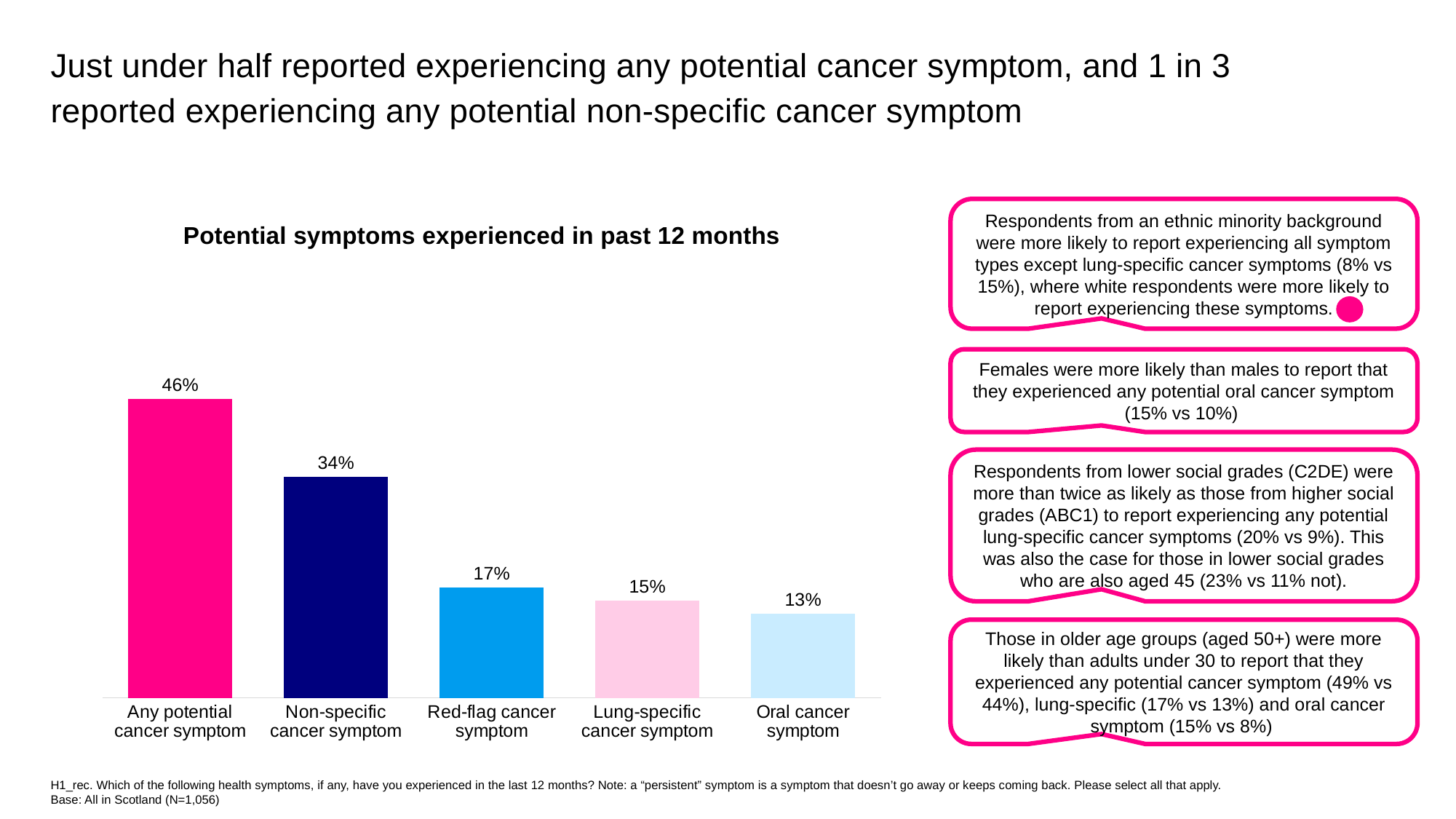
What is the difference between Red-flag cancer symptom and Oral cancer symptom? 4% What is the title of the chart? Potential symptoms experienced in past 12 months How many categories are shown in the chart? 5 What is the difference between Any potential cancer symptom and Non-specific cancer symptom? 12% What is the value for Oral cancer symptom? 13% Which category has the lowest value? Oral cancer symptom What percentage reported experiencing any potential cancer symptom? 46% What is the value for Non-specific cancer symptom? 34% What is the value for Lung-specific cancer symptom? 15% What kind of chart is shown? Bar chart Which is larger, Red-flag cancer symptom or Lung-specific cancer symptom? Red-flag cancer symptom Which category has the highest value? Any potential cancer symptom